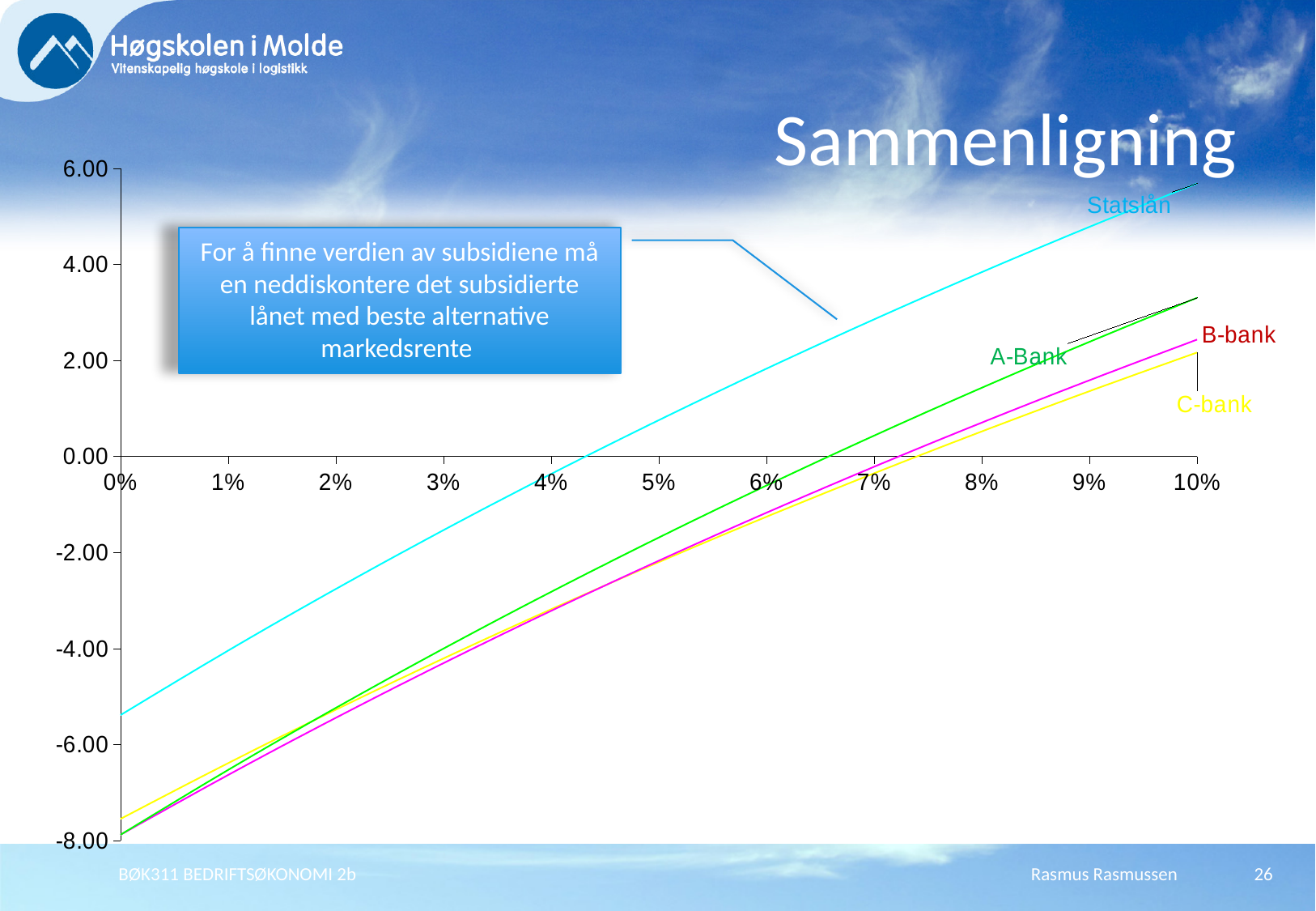
What is the lowest value shown on the y axis of the chart? -8.00 What kind of chart is shown on the slide? line chart At 10%, which is larger: the value for Statslån or the value for A-Bank? Statslån Do the values of the Statslån line rise or fall as the interest rate on the x axis increases from 0% to 10%? rise What is the title of the slide containing the chart? Sammenligning Is the value of C-bank at 0% greater or less than -6.00? less Is the value of Statslån at 0% greater or less than -4.00? less How many lines (series) are plotted on the chart? 4 Is the value of A-Bank at 10% greater or less than 2.00? greater Which series has the highest value at 10%? Statslån Which series has the highest value at 0%? Statslån